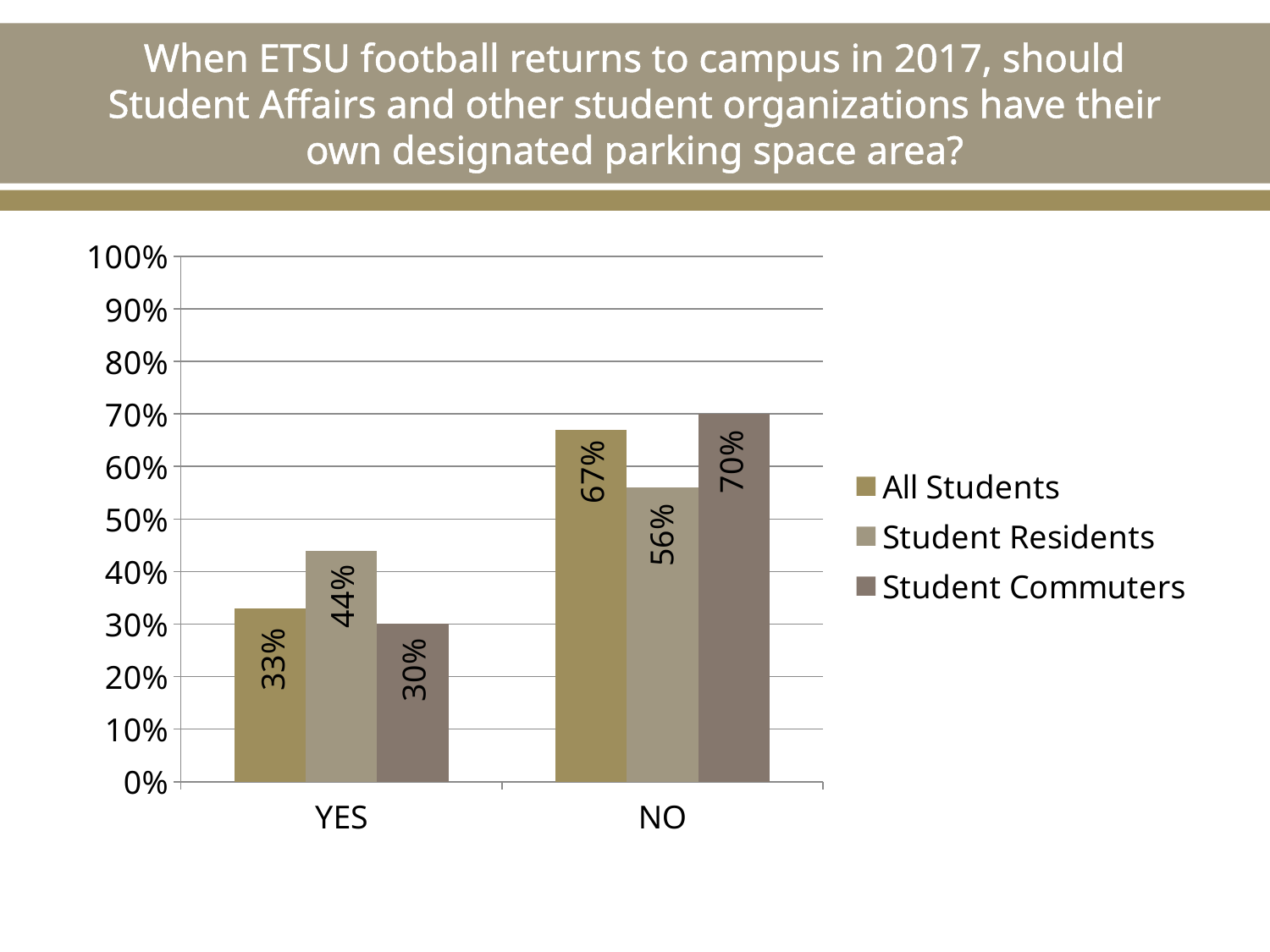
What percentage of Student Commuters answered YES? 30% What percentage of Student Residents answered NO? 56% What percentage of Student Commuters answered NO? 70% What percentage of All Students answered YES? 33% What kind of chart is shown on the slide? Bar chart Which series has the highest value for YES? Student Residents Which is larger: the YES value for Student Residents or the YES value for Student Commuters? Student Residents How many series does the legend list? 3 What is the difference between the NO and YES percentages for All Students? 34% How many categories are shown on the x axis? 2 Which legend entry is shown in the darkest colour? Student Commuters Which series has the lowest value for NO? Student Residents